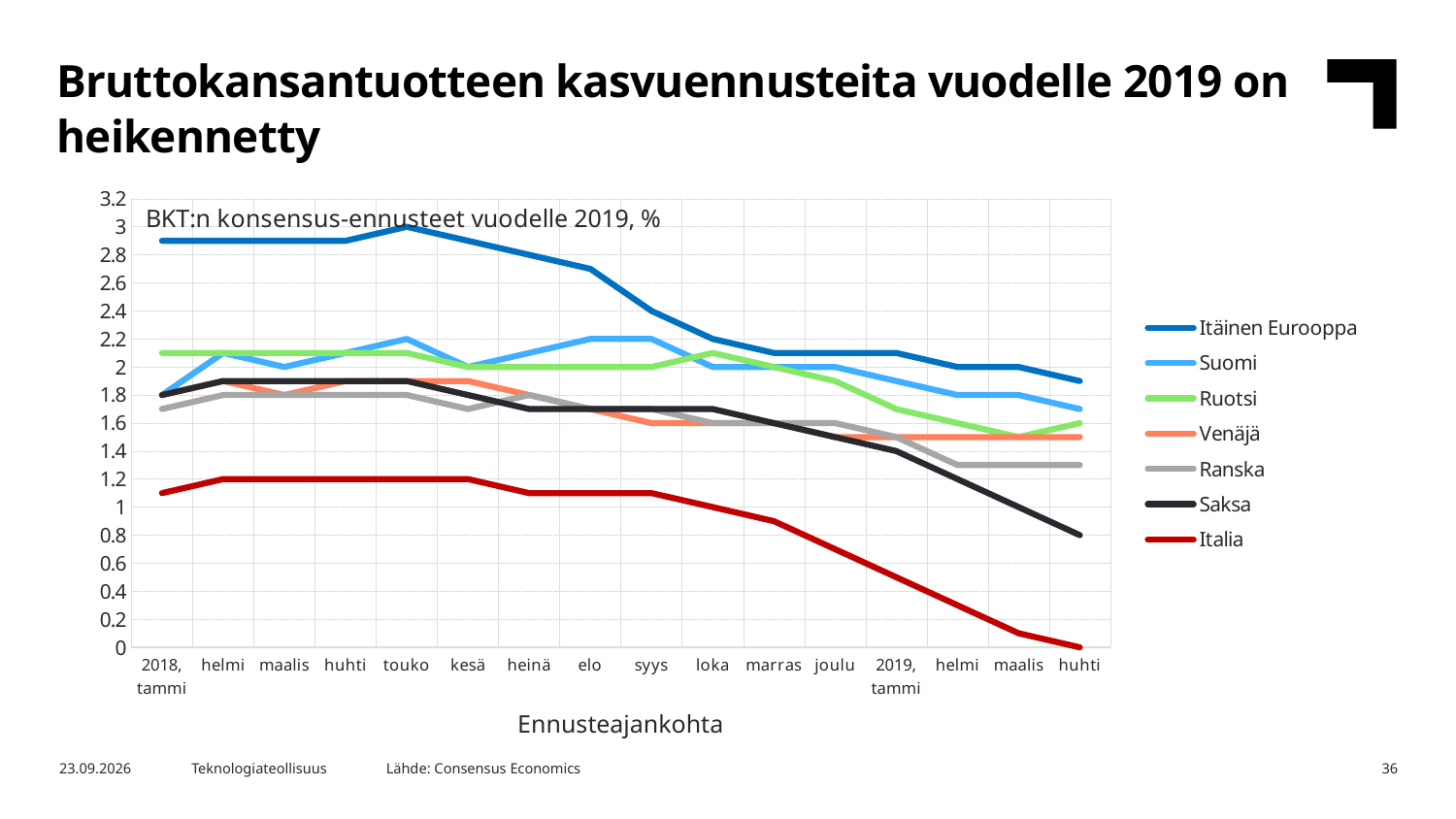
Is the value for Itäinen Eurooppa at 2018 tammi greater or less than 2.6? greater What is the title printed inside the chart area? BKT:n konsensus-ennusteet vuodelle 2019, % Does the Italia series rise or fall from 2018 tammi to 2019 huhti? fall What is the value for Itäinen Eurooppa at touko (2018)? 3 How many series does the legend list? 7 What kind of chart is shown on the slide? line chart Which series has the highest value at 2018 tammi? Itäinen Eurooppa How many forecast time points are shown along the x axis? 16 Is the value for Italia at 2019 tammi greater or less than 1? less What is the value for Italia at 2019 huhti? 0 What is the x-axis title of the chart? Ennusteajankohta Which series has the lowest value at 2019 huhti? Italia